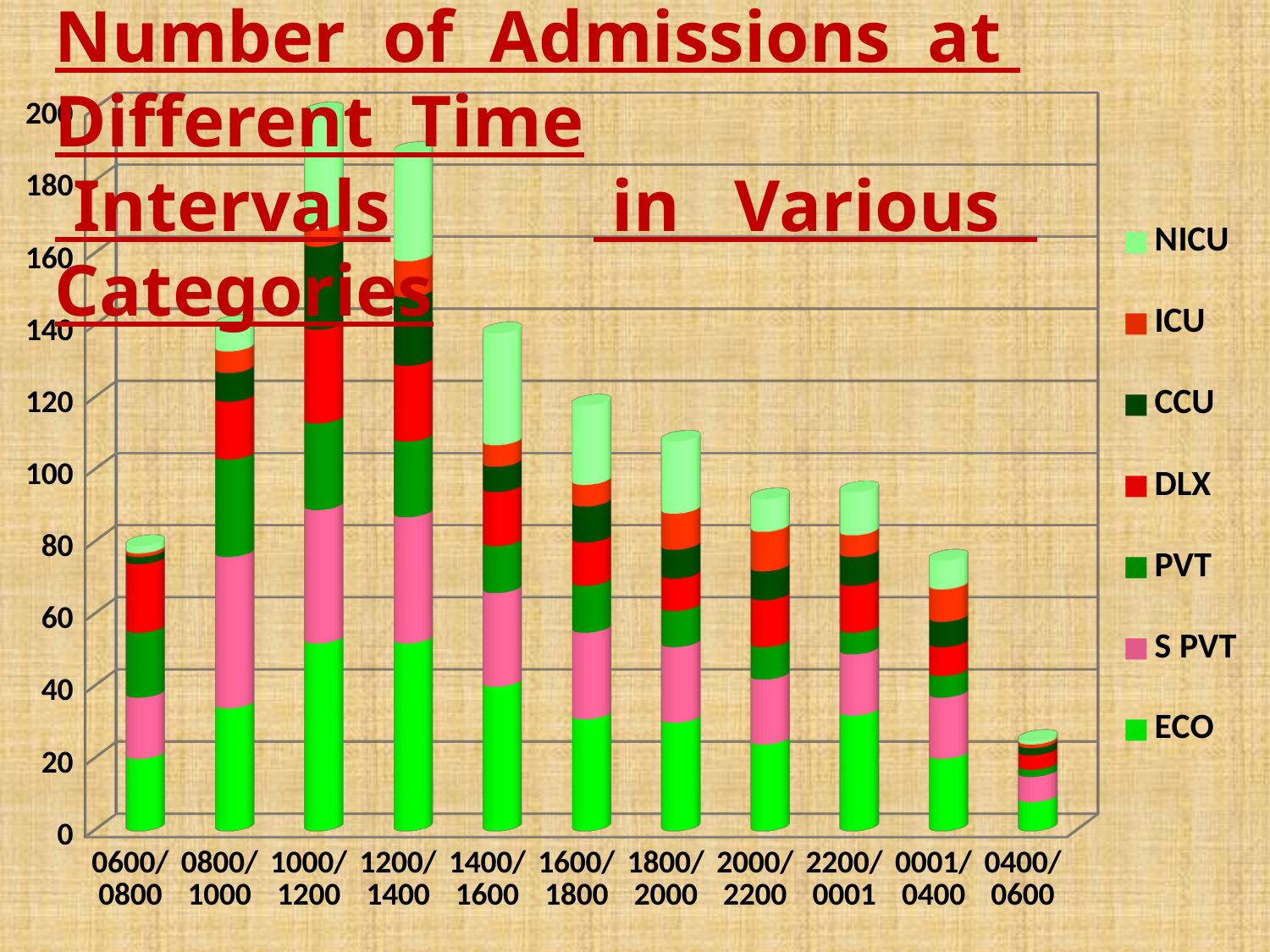
How many time intervals are shown along the x axis? 11 Is the total number of admissions for 0001/0400 greater or less than 80? less Which time interval has the highest total number of admissions? 1000/1200 Is the total number of admissions for 1800/2000 greater or less than 100? greater Do the total admissions rise or fall from 1200/1400 through 2000/2200? fall Which series forms the bottom segment of each stacked bar? ECO Which has a larger total number of admissions, 1200/1400 or 1400/1600? 1200/1400 How many series does the legend list? 7 Which time interval has the lowest total number of admissions? 0400/0600 What kind of chart is shown on the slide? Stacked bar chart Is the total number of admissions for 0400/0600 greater or less than 40? less